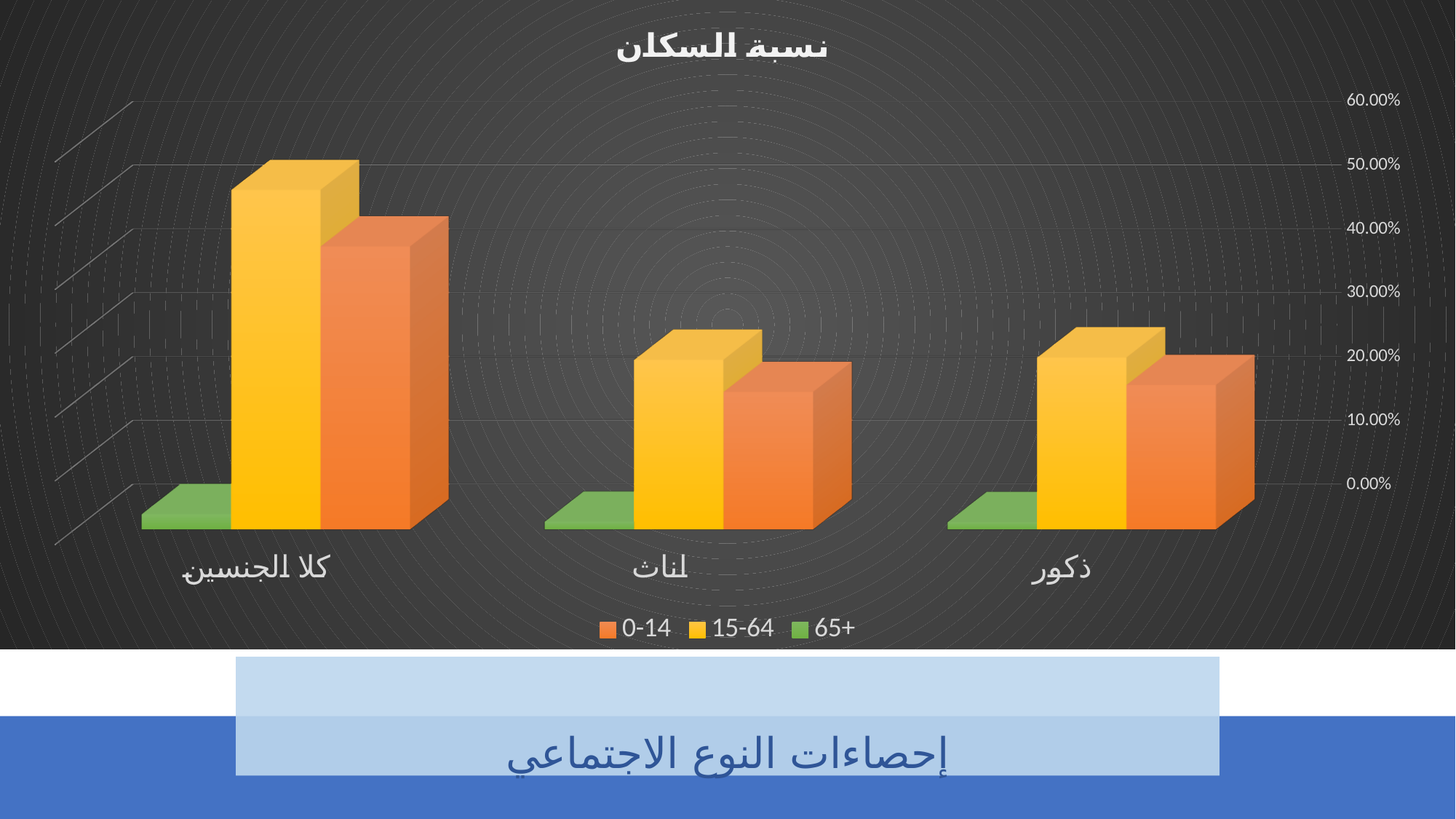
Which series has the lowest value in the ذكور category? 65+ Is the value for 15-64 in the كلا الجنسين category greater or less than 30.00%? greater What is the title of the chart? نسبة السكان Is the value for 0-14 in the كلا الجنسين category greater or less than 20.00%? greater Which category has the highest value for the 15-64 series? كلا الجنسين How many categories are shown on the x axis of the chart? 3 Is the value for 15-64 in the ذكور category greater or less than 10.00%? greater How many series does the legend list? 3 Which series is shown in green in the legend? 65+ In the كلا الجنسين category, which is larger: the 15-64 value or the 0-14 value? 15-64 What kind of chart is shown on the slide? bar chart